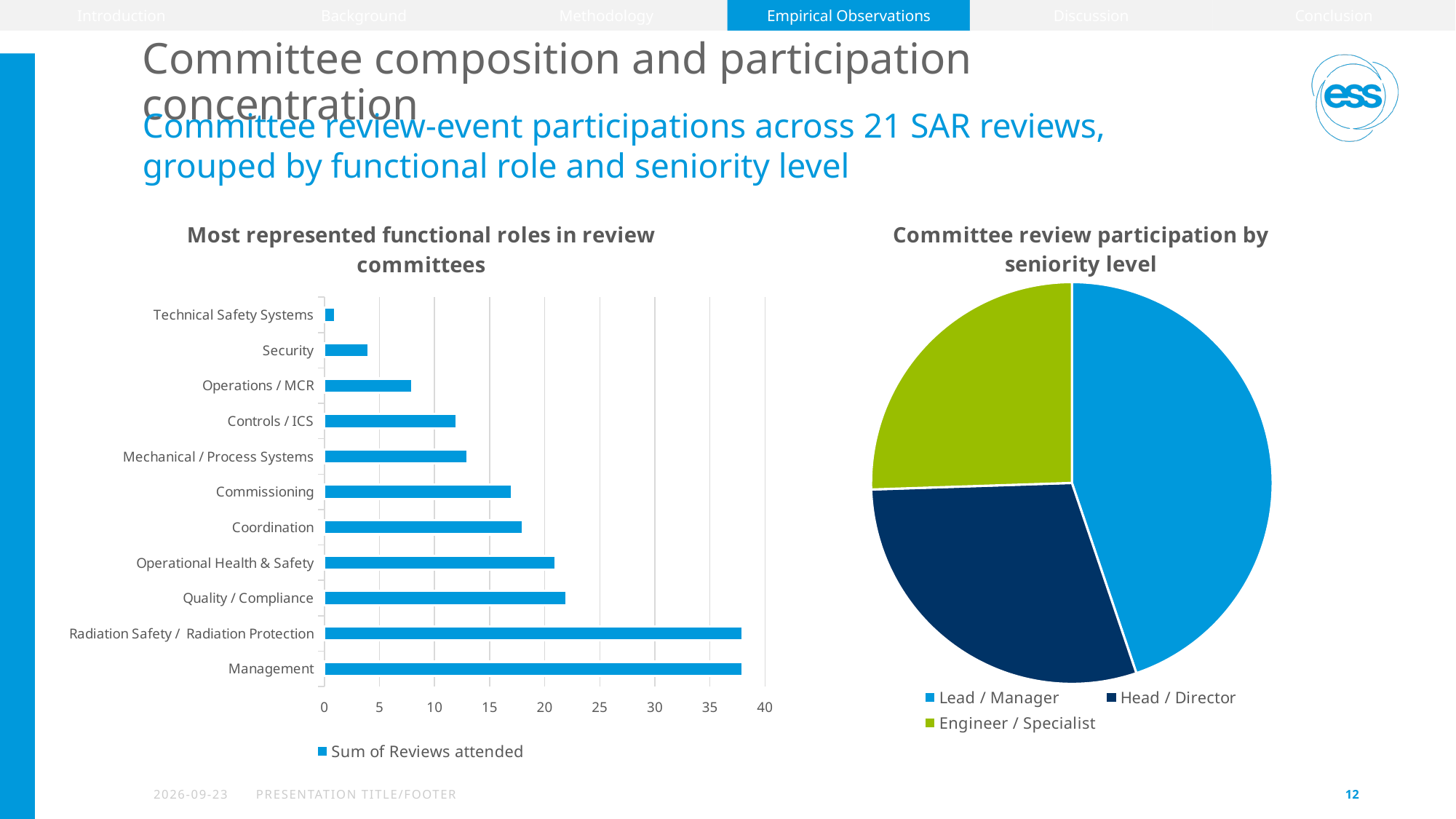
In the 'Most represented functional roles in review committees' chart, which functional role has the lowest value? Technical Safety Systems In the 'Most represented functional roles in review committees' chart, is the value for Quality / Compliance greater or less than 20? greater How many slices does the 'Committee review participation by seniority level' pie chart have? 3 In the 'Most represented functional roles in review committees' chart, is the value for Management greater or less than 35? greater What kind of chart is the 'Committee review participation by seniority level' chart? pie chart In the 'Most represented functional roles in review committees' chart, is the value for Security greater or less than 5? less In the 'Committee review participation by seniority level' chart, which seniority level has the largest slice? Lead / Manager What kind of chart is the 'Most represented functional roles in review committees' chart? bar chart In the 'Most represented functional roles in review committees' chart, how many functional roles are plotted? 11 In the 'Most represented functional roles in review committees' chart, which is larger: Commissioning or Operations / MCR? Commissioning How many series does the legend of the 'Most represented functional roles in review committees' chart list? 1